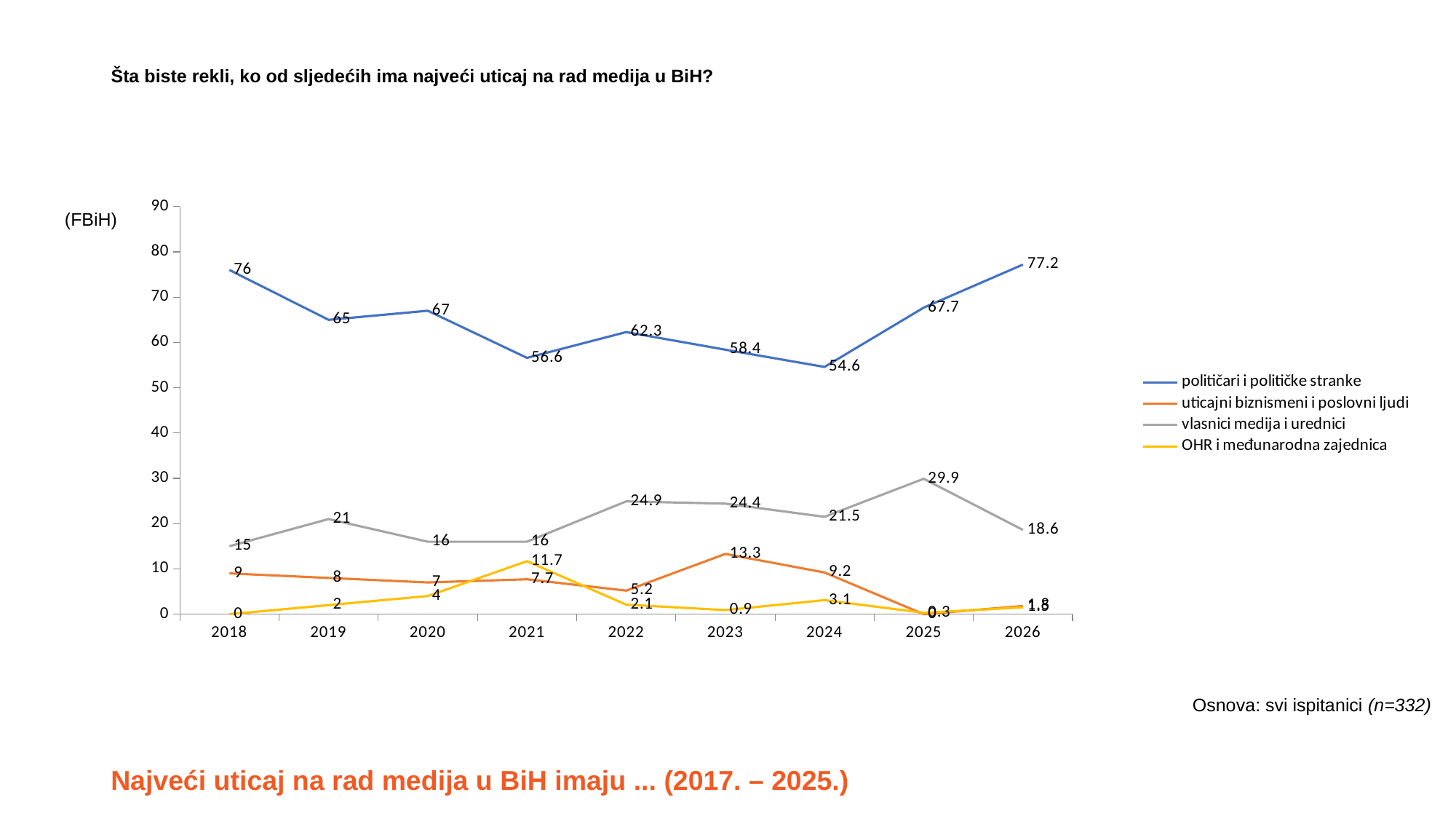
What value is shown for 'vlasnici medija i urednici' in 2025? 29.9 What value is shown for 'OHR i međunarodna zajednica' in 2021? 11.7 What value is shown for 'uticajni biznismeni i poslovni ljudi' in 2023? 13.3 In 2023, which is larger: 'uticajni biznismeni i poslovni ljudi' or 'OHR i međunarodna zajednica'? uticajni biznismeni i poslovni ljudi What is the difference between the 2025 and 2026 values for 'vlasnici medija i urednici'? 11.3 What value is shown for 'političari i političke stranke' in 2018? 76 In which year does 'vlasnici medija i urednici' reach its highest value? 2025 What is the difference between the 2026 and 2018 values for 'političari i političke stranke'? 1.2 How many years are shown on the x axis of the chart? 9 In which year does 'političari i političke stranke' have its lowest value? 2024 How many series does the legend list? 4 In which year does 'političari i političke stranke' reach its highest value? 2026